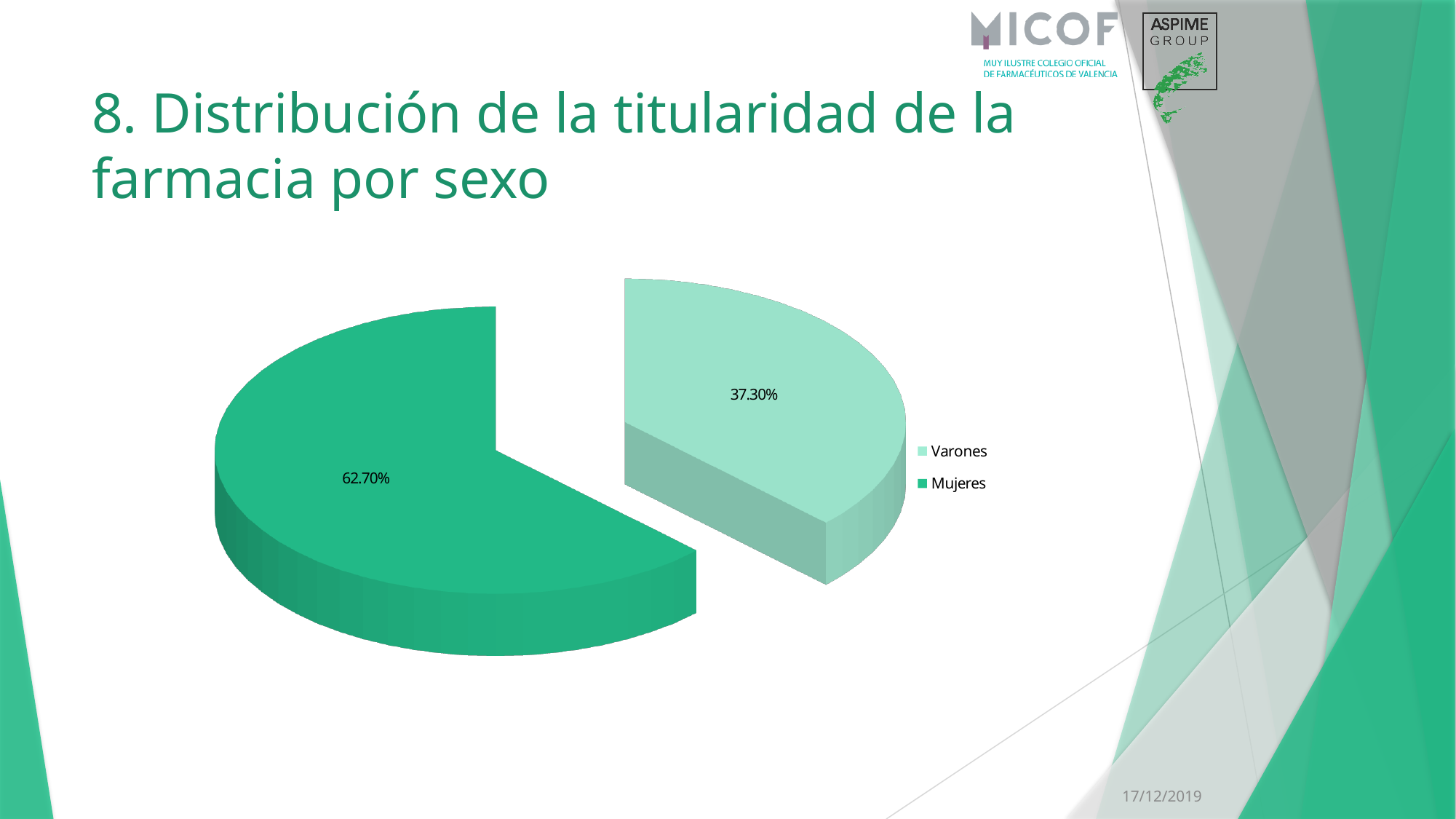
What kind of chart is shown on the slide? Pie chart How many entries does the legend list? 2 Which is larger, the share for Varones or the share for Mujeres? Mujeres How many categories does the pie chart show? 2 What is the difference between the Mujeres and Varones percentages? 25.40% Which legend entry is shown in the lighter green colour? Varones What is the value shown for Varones? 37.30% Which category has the smallest slice of the pie? Varones What share of the pie does the Varones slice represent? 37.30% Which category has the largest slice of the pie? Mujeres What is the value shown for Mujeres? 62.70% What is the title of the slide containing the chart? 8. Distribución de la titularidad de la farmacia por sexo